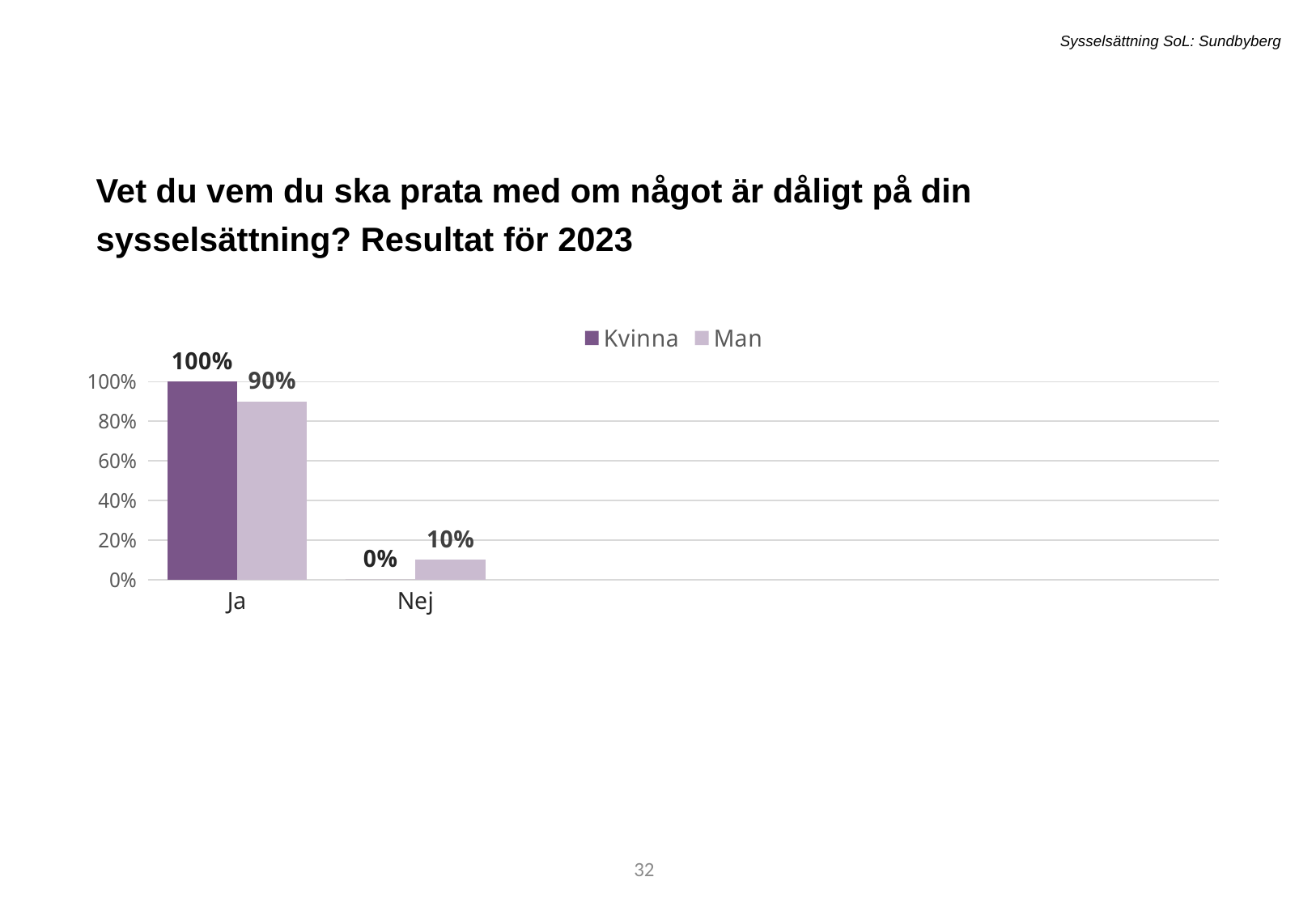
What kind of chart is shown on the slide? Bar chart What is the value for Kvinna in the Ja category? 100% What is the value for Man in the Nej category? 10% Which is larger in the Nej category, Kvinna or Man? Man Which category has the lowest value for Kvinna? Nej What is the difference between the Kvinna and Man values in the Ja category? 10% What are the two series names listed in the legend? Kvinna and Man How many series does the legend list? 2 What is the value for Kvinna in the Nej category? 0% What is the value for Man in the Ja category? 90% How many categories are shown on the x axis? 2 Which category has the highest value for Man? Ja